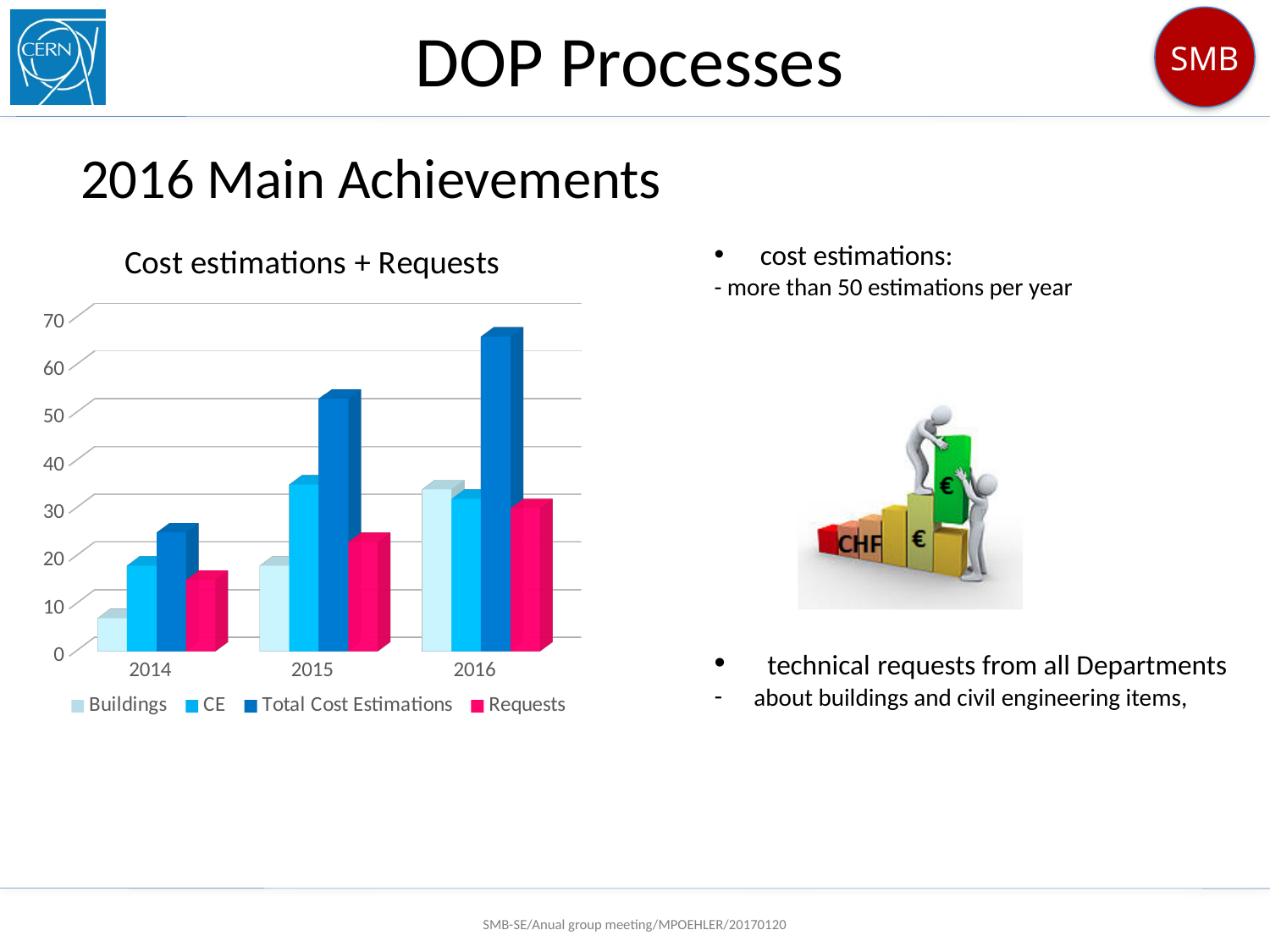
How many series does the legend of the 'Cost estimations + Requests' chart list? 4 Do the Total Cost Estimations values rise or fall from 2014 to 2016? rise Is the Total Cost Estimations value for 2016 greater or less than 60? greater What is the title of the chart on the slide? Cost estimations + Requests In which year is the Total Cost Estimations bar highest? 2016 Is the Buildings value for 2014 greater or less than 10? less In which year is the Buildings bar lowest? 2014 Which series is shown in pink/magenta in the 'Cost estimations + Requests' chart? Requests Which is larger, the Total Cost Estimations value for 2015 or for 2016? 2016 How many years are shown on the x axis of the 'Cost estimations + Requests' chart? 3 What kind of chart is shown under the title 'Cost estimations + Requests'? bar chart Is the CE value for 2015 greater or less than 30? greater